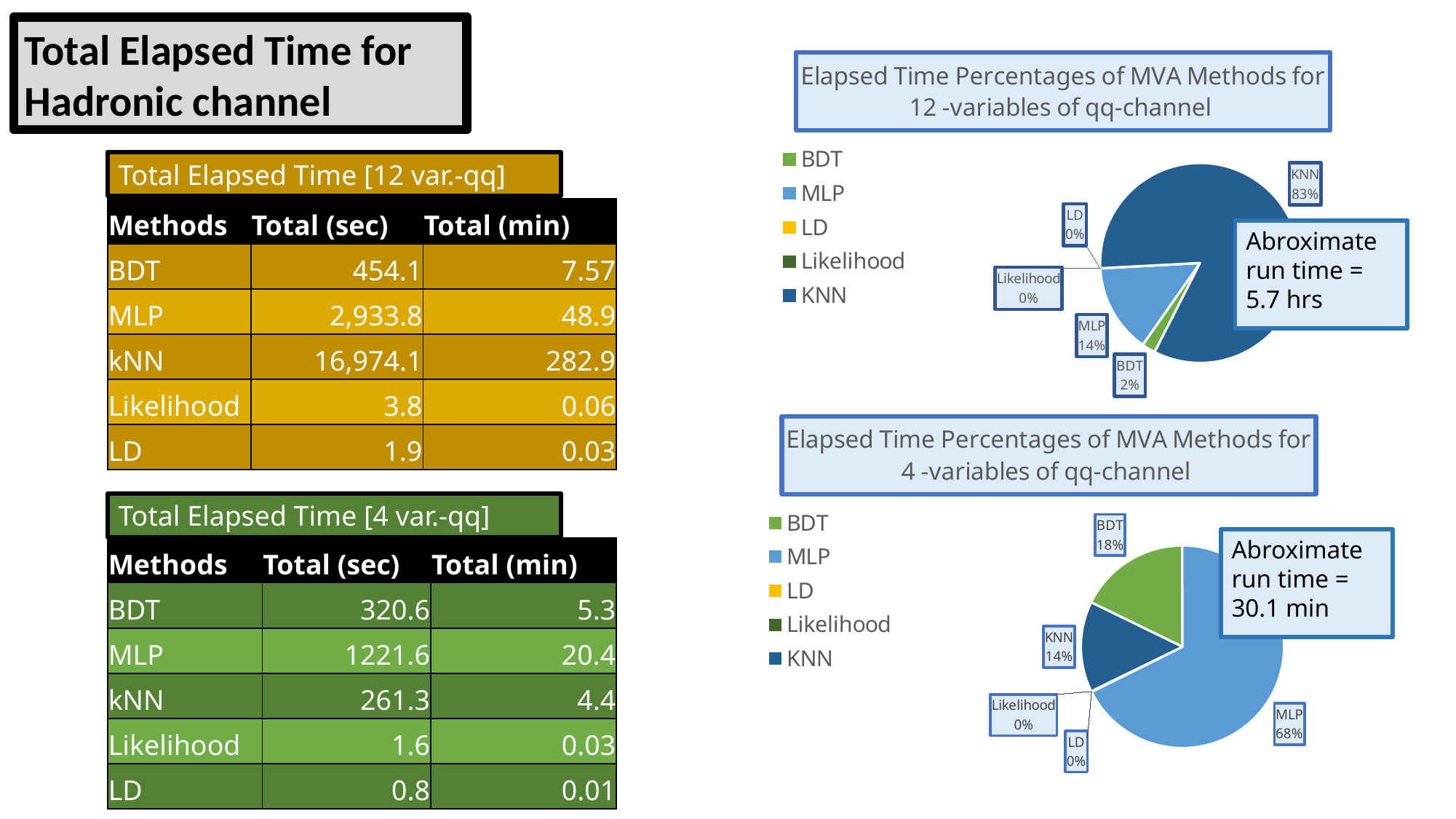
In the pie chart for 4-variables of qq-channel, which is larger, the share for BDT or the share for KNN? BDT In the pie chart for 4-variables of qq-channel, what percentage is shown for BDT? 18% In the pie chart for 4-variables of qq-channel, what percentage is shown for MLP? 68% What type of chart is used to show the elapsed time percentages for 4-variables of qq-channel? Pie chart In the pie chart for 12-variables of qq-channel, which method has the largest share? KNN In the pie chart for 12-variables of qq-channel, what percentage is shown for MLP? 14% In the pie chart for 4-variables of qq-channel, which method has the largest share? MLP What approximate run time is annotated on the pie chart for 12-variables of qq-channel? 5.7 hrs In the pie chart for 12-variables of qq-channel, what is the difference in percentage points between KNN and MLP? 69 In the pie chart for 4-variables of qq-channel, what is the difference in percentage points between MLP and BDT? 50 In the pie chart for 12-variables of qq-channel, what percentage is shown for KNN? 83% How many entries does the legend list in the pie chart for 12-variables of qq-channel? 5